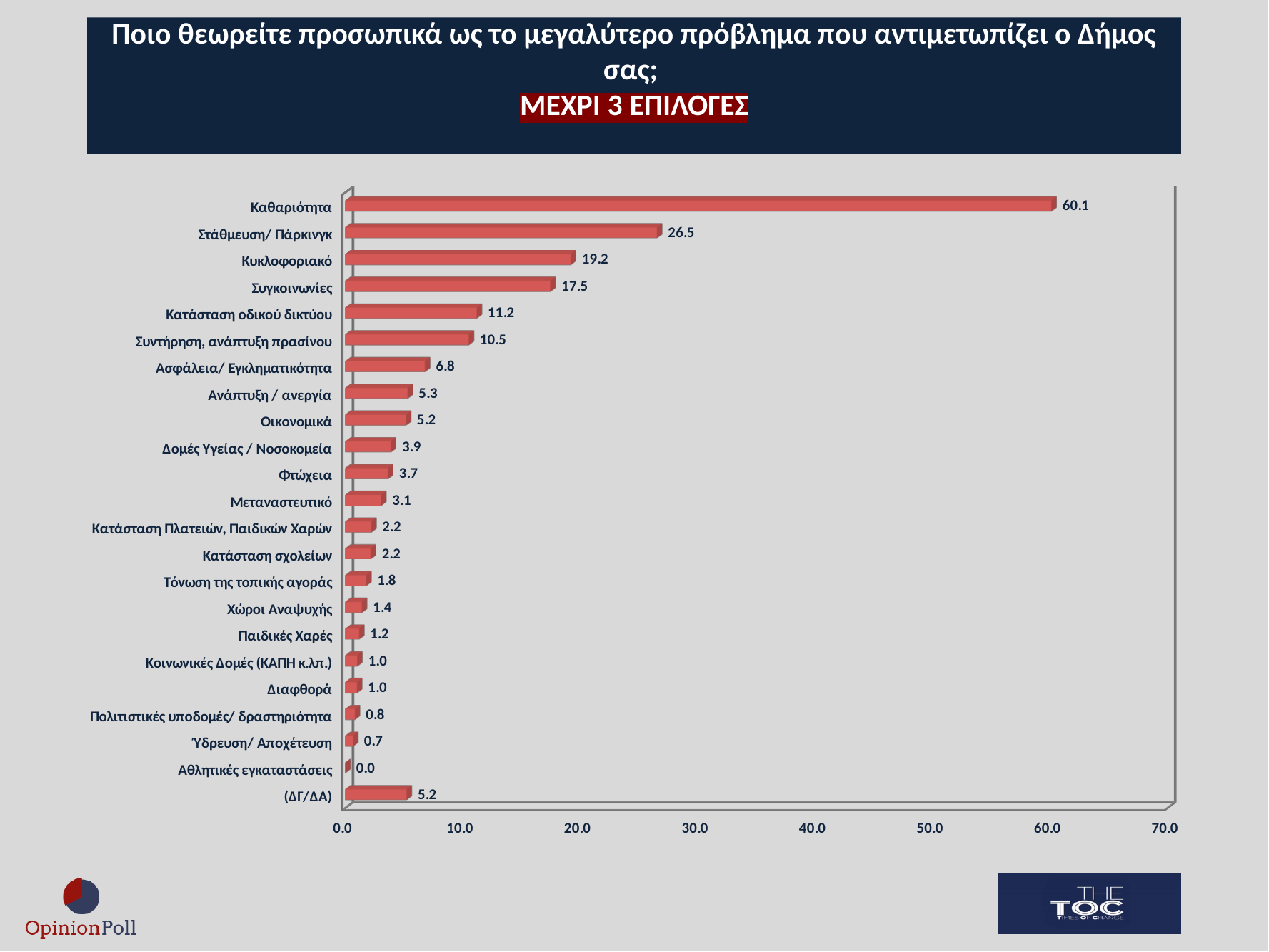
Which category has the lowest value? Αθλητικές εγκαταστάσεις What is the value for (ΔΓ/ΔΑ)? 5.2 What is the difference between the values for Κυκλοφοριακό and Συγκοινωνίες? 1.7 What is the difference between the values for Καθαριότητα and Στάθμευση/ Πάρκινγκ? 33.6 Which category has the highest value? Καθαριότητα What is the value for Συντήρηση, ανάπτυξη πρασίνου? 10.5 What is the value for Καθαριότητα? 60.1 How many categories are shown in the chart? 23 Is the value for Κατάσταση οδικού δικτύου greater or less than 10.0? greater Which is larger, the value for Ασφάλεια/ Εγκληματικότητα or the value for Φτώχεια? Ασφάλεια/ Εγκληματικότητα What is the value for Στάθμευση/ Πάρκινγκ? 26.5 What kind of chart is shown on the slide? bar chart